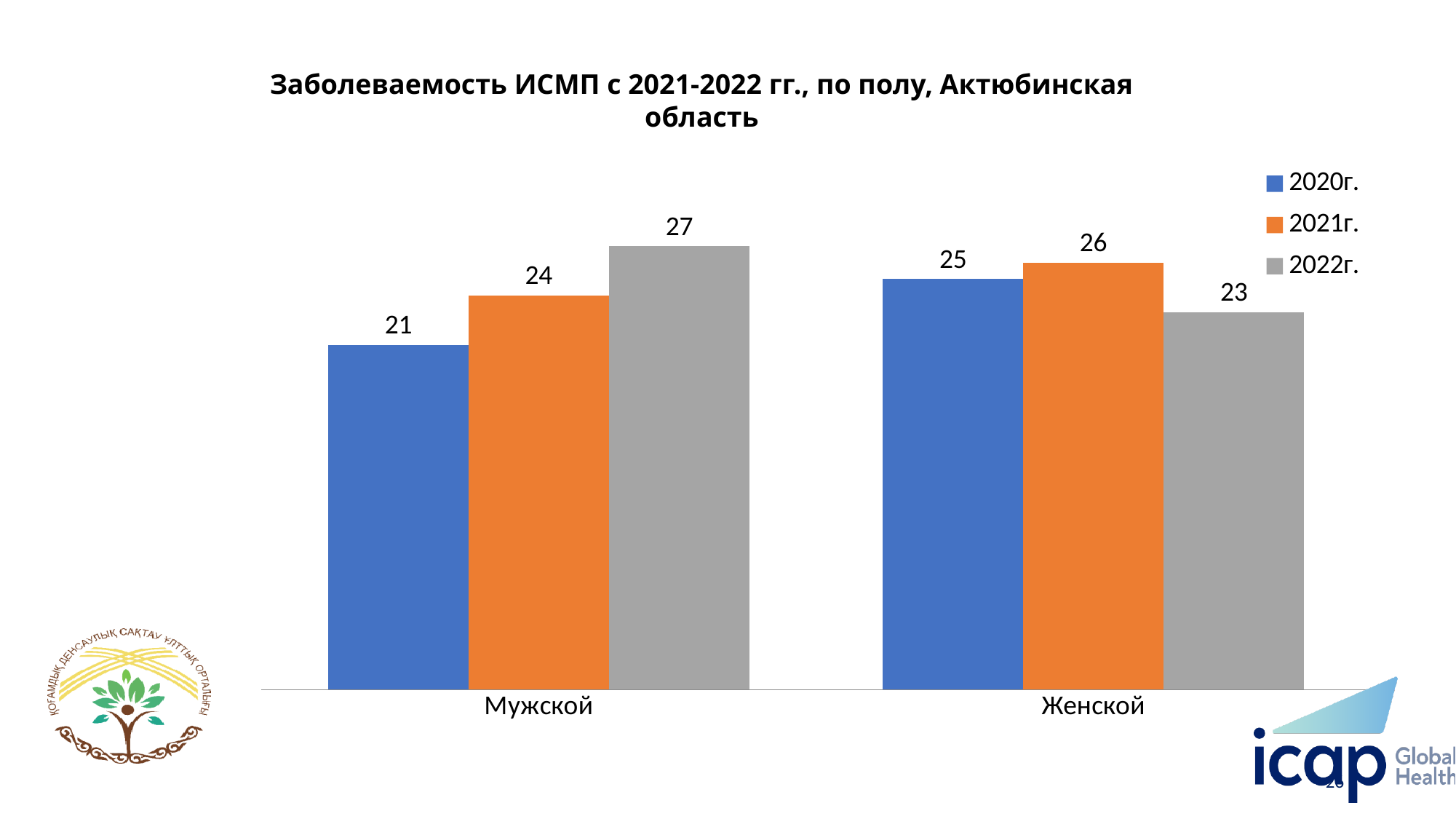
How many series does the legend list? 3 What is the difference between the 2022г. values for Мужской and Женской? 4 What is the value for Мужской in 2020г.? 21 What kind of chart is shown on the slide? Bar chart Which year has the lowest value for Женской? 2022г. How many categories are shown on the x axis? 2 What is the value for Женской in 2022г.? 23 Do the values for Мужской rise or fall from 2020г. to 2022г.? Rise Which year has the highest value for Мужской? 2022г. Which is larger: the 2020г. value for Мужской or the 2020г. value for Женской? Женской Which colour represents 2021г. in the legend? Orange What is the value for Мужской in 2021г.? 24